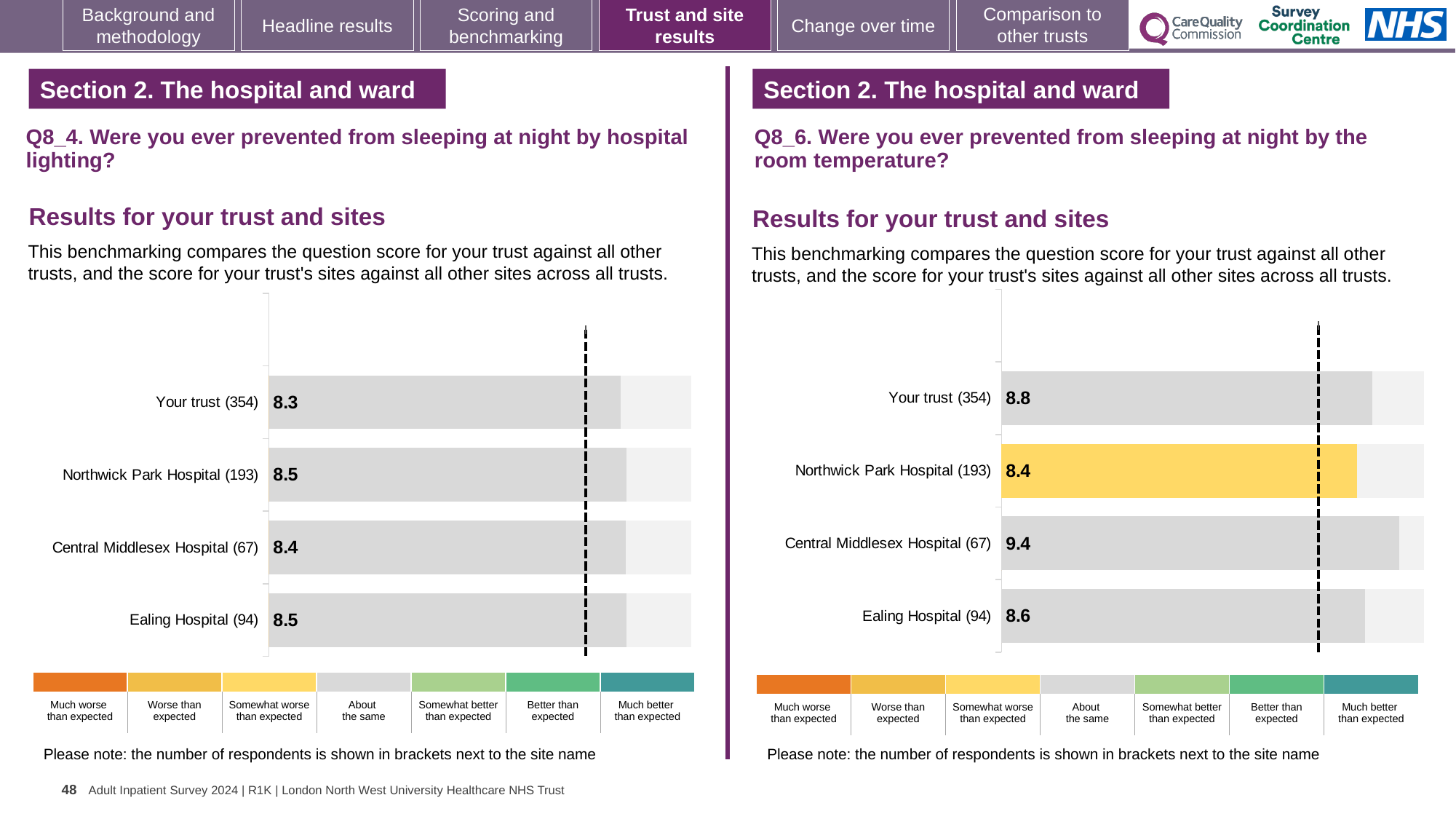
On the Q8_6 chart (room temperature), which is larger: the score for Your trust (354) or Ealing Hospital (94)? Ealing Hospital (94) On the Q8_4 chart (hospital lighting), what is the score for Central Middlesex Hospital (67)? 8.4 On the Q8_6 chart (room temperature), what is the difference between the scores for Central Middlesex Hospital (67) and Ealing Hospital (94)? 0.8 On the Q8_4 chart (hospital lighting), how many bars are plotted? 4 On the Q8_6 chart (room temperature), what is the score for Central Middlesex Hospital (67)? 9.4 On the Q8_4 chart (hospital lighting), which category has the lowest score? Your trust (354) On the Q8_6 chart (room temperature), which category has the highest score? Central Middlesex Hospital (67) What type of chart is used on the Q8_4 chart (hospital lighting)? Bar chart On the Q8_4 chart (hospital lighting), what is the score for Your trust (354)? 8.3 On the Q8_4 chart (hospital lighting), what is the difference between the scores for Ealing Hospital (94) and Your trust (354)? 0.2 On the Q8_6 chart (room temperature), what is the score for Northwick Park Hospital (193)? 8.4 On the Q8_6 chart (room temperature), which category has the lowest score? Northwick Park Hospital (193)